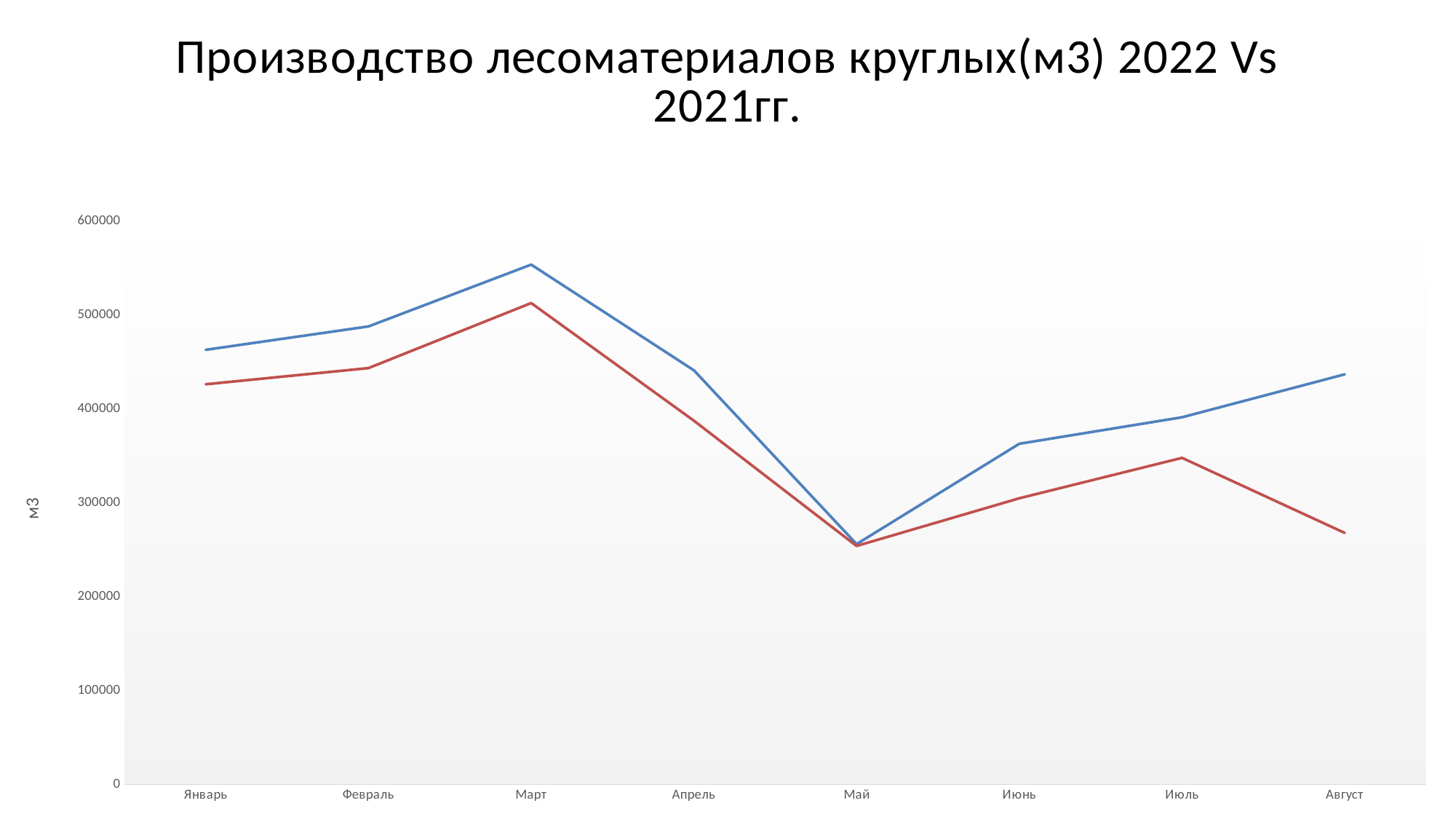
What is the label on the vertical axis of the chart? м3 What kind of chart is shown on the slide? line chart Is the value of the blue line for Май greater or less than 300000? less In which month does the red line reach its highest value? Март Is the value of the blue line for Август greater or less than 400000? greater In which month does the blue line reach its highest value? Март In which month does the blue line reach its lowest value? Май Does the red line rise or fall from Июль to Август? fall Is the value of the blue line for Март greater or less than 500000? greater Which line has the higher value in Август, the blue line or the red line? the blue line How many months are shown on the x axis of the chart? 8